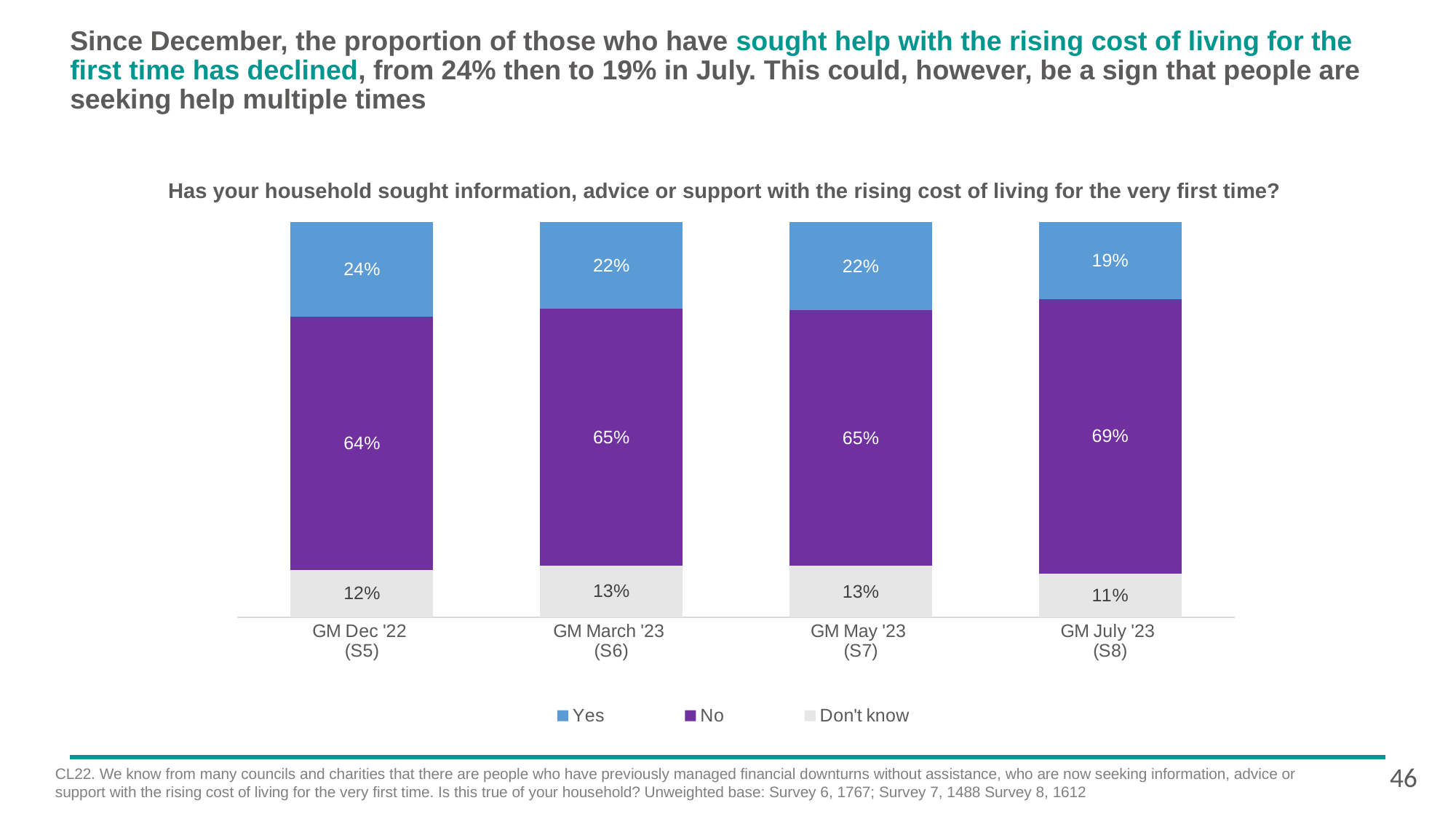
What percentage answered 'No' in GM July '23 (S8)? 69% Does the 'Yes' percentage rise or fall from GM Dec '22 to GM July '23? Fall Is the 'No' percentage larger in GM July '23 (S8) or GM Dec '22 (S5)? GM July '23 (S8) What percentage answered 'Yes' in GM Dec '22 (S5)? 24% What is the difference between the 'Yes' percentage in GM Dec '22 (S5) and GM July '23 (S8)? 5% Which survey wave has the highest 'Yes' percentage? GM Dec '22 (S5) What percentage answered 'Don't know' in GM May '23 (S7)? 13% How many series does the legend list? 3 Which survey wave has the lowest 'Don't know' percentage? GM July '23 (S8) How many survey waves are shown on the x axis? 4 What kind of chart is shown? Stacked bar chart What percentage answered 'Yes' in GM March '23 (S6)? 22%